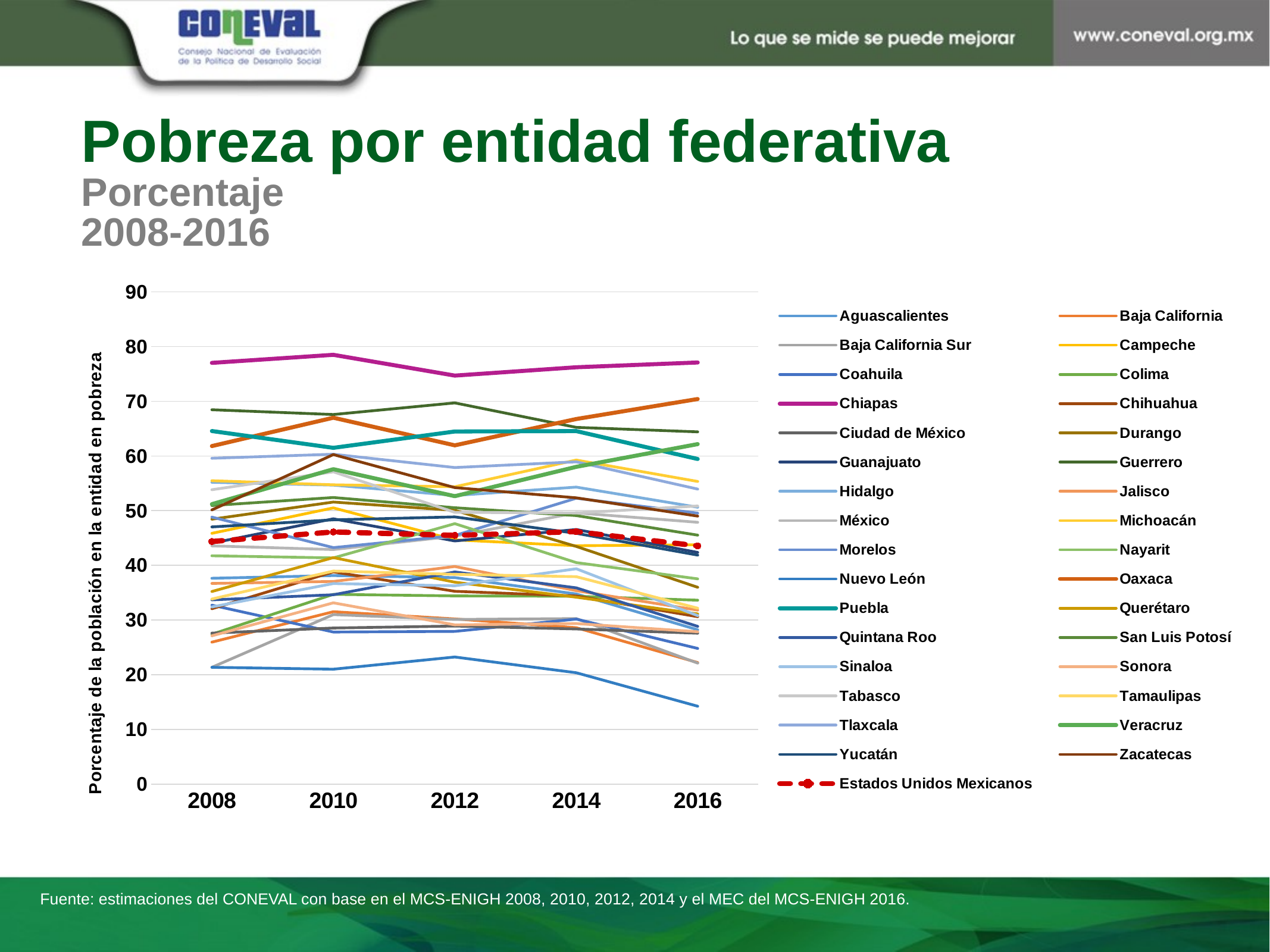
Which is larger in 2008, the value for Chiapas or the value for Oaxaca? Chiapas How many years are plotted along the x axis? 5 Is the value for Chiapas in 2016 greater or less than 70? greater Is the value for Nuevo León in 2016 greater or less than 20? less Does the value for Nuevo León rise or fall between 2008 and 2016? fall Which series has the highest value in 2016? Chiapas How many series does the legend list? 33 Which series has the lowest value in 2016? Nuevo León Is the value for Estados Unidos Mexicanos in 2014 greater or less than 50? less What kind of chart is shown on the slide? line chart Which legend entry is drawn with a red dashed line? Estados Unidos Mexicanos